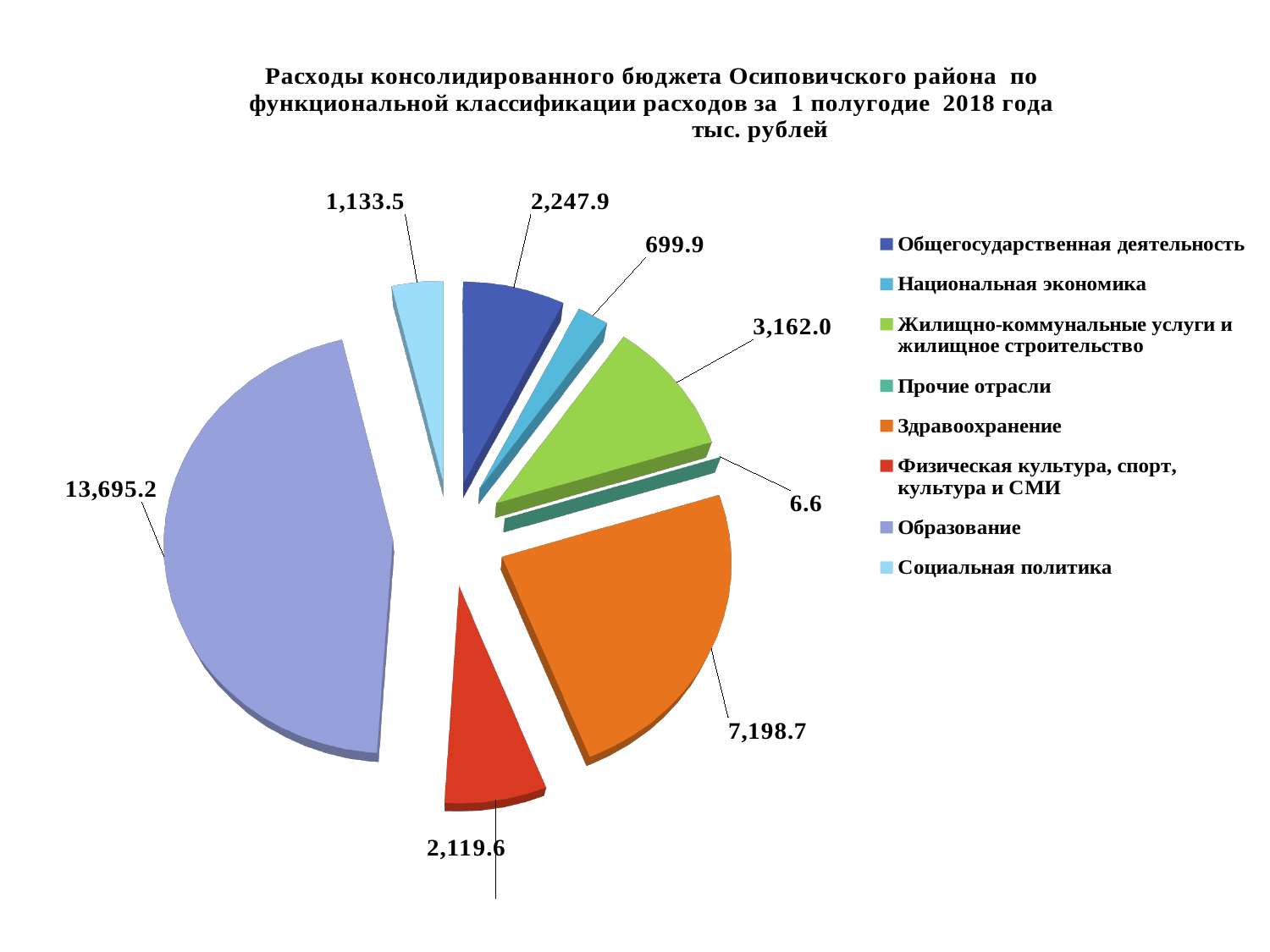
Which category has the largest slice of the pie? Образование What is the value for Здравоохранение? 7,198.7 How many categories does the pie chart have? 8 What is the difference between the values for Образование and Здравоохранение? 6,496.5 What is the value for Национальная экономика? 699.9 What type of chart is shown on the slide? pie chart Which is larger: Жилищно-коммунальные услуги и жилищное строительство or Общегосударственная деятельность? Жилищно-коммунальные услуги и жилищное строительство What is the value for Образование? 13,695.2 What is the value for Прочие отрасли? 6.6 Which category has the smallest slice of the pie? Прочие отрасли What is the total of all the slices in the pie chart? 30,263.4 What colour is the slice for Социальная политика? light blue